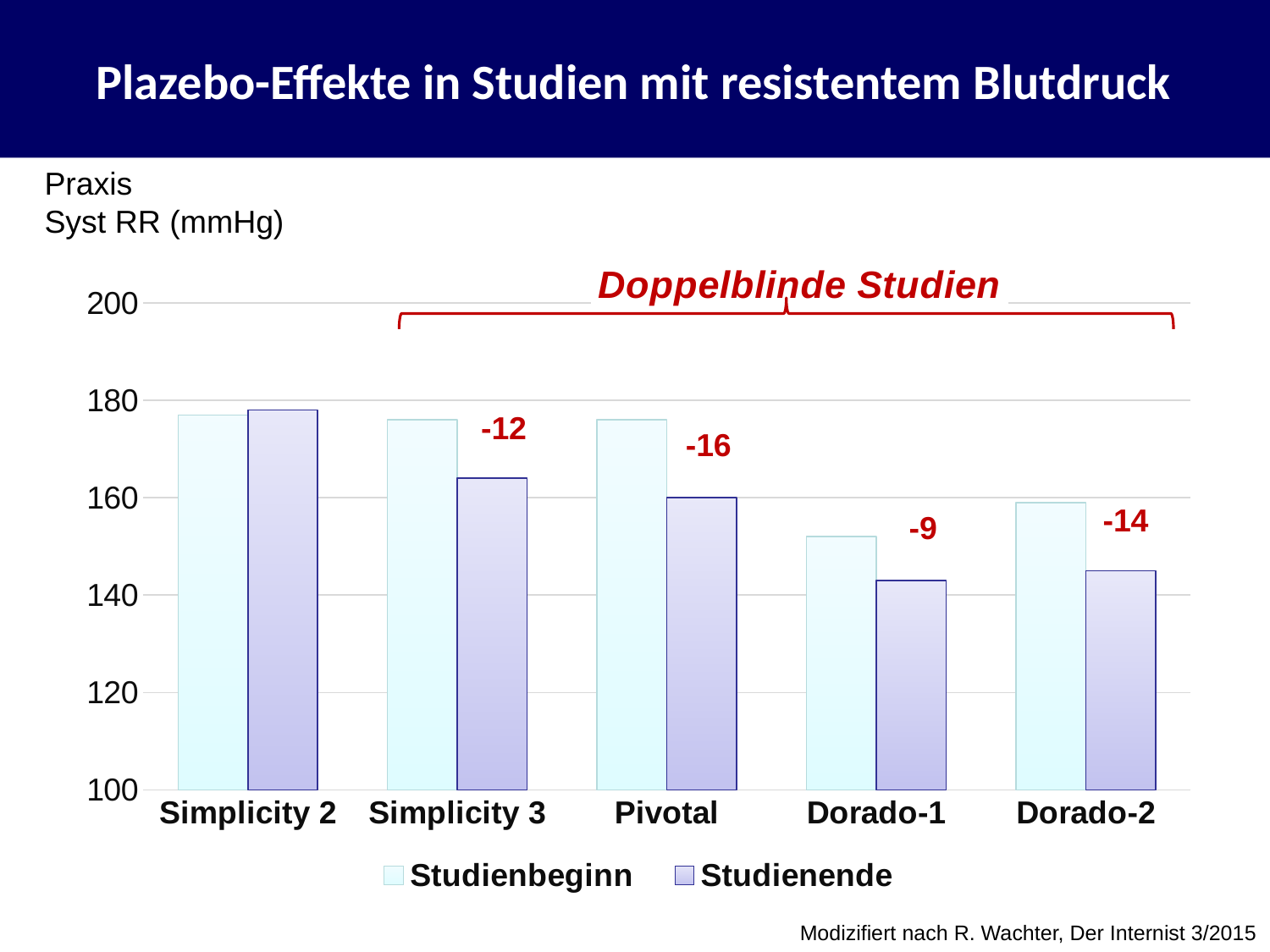
Is the Studienende value for Dorado-1 greater or less than 160? less How many series does the legend list? 2 Which is larger: the Studienbeginn value for Pivotal or the Studienbeginn value for Dorado-2? Pivotal What kind of chart is shown on the slide? bar chart What change is annotated in red for Simplicity 3? -12 What change is annotated in red for Dorado-1? -9 Which study has the lowest Studienbeginn value? Dorado-1 Which study has the highest Studienende value? Simplicity 2 What change is annotated in red for Dorado-2? -14 What change is annotated in red above the Studienende bar for Pivotal? -16 How many studies (categories) are shown on the x axis? 5 What are the two series named in the legend? Studienbeginn and Studienende